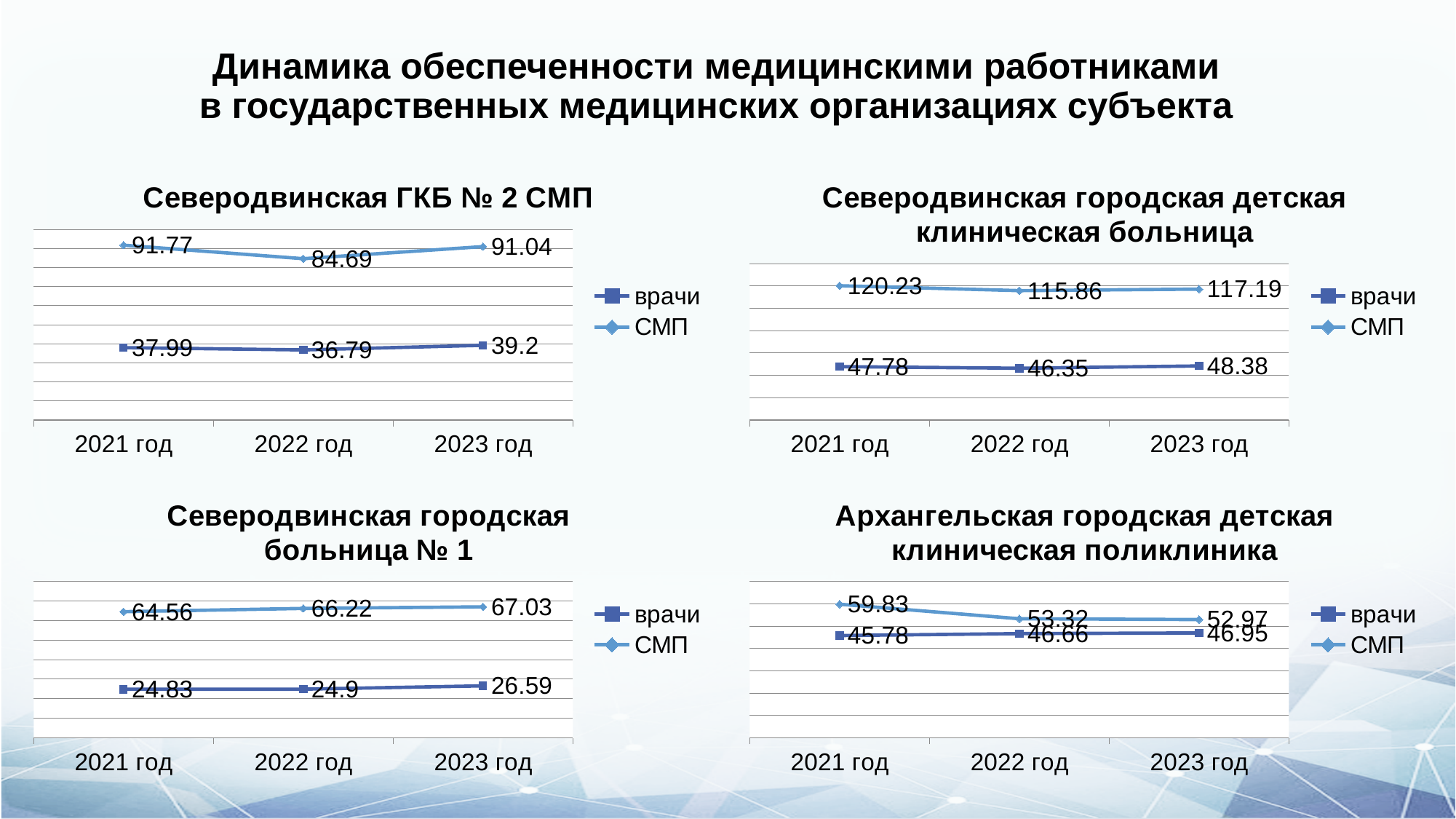
In the chart titled 'Архангельская городская детская клиническая поликлиника', what is the value for СМП in 2023 год? 52.97 In the chart titled 'Северодвинская городская больница № 1', how many series does the legend list? 2 In the chart titled 'Северодвинская ГКБ № 2 СМП', what is the difference between the СМП value in 2021 год and in 2022 год? 7.08 In the chart titled 'Северодвинская городская больница № 1', does the СМП value rise or fall from 2021 год to 2023 год? rise In the chart titled 'Северодвинская ГКБ № 2 СМП', what is the value for врачи in 2023 год? 39.2 In the chart titled 'Северодвинская городская детская клиническая больница', in which year is the врачи value lowest? 2022 год In the chart titled 'Северодвинская городская детская клиническая больница', how many years are shown on the x axis? 3 What kind of chart is the one titled 'Архангельская городская детская клиническая поликлиника'? line chart In the chart titled 'Северодвинская городская детская клиническая больница', what is the value for СМП in 2021 год? 120.23 In the chart titled 'Северодвинская городская больница № 1', what is the value for врачи in 2021 год? 24.83 In the chart titled 'Северодвинская ГКБ № 2 СМП', what is the value for СМП in 2022 год? 84.69 In the chart titled 'Архангельская городская детская клиническая поликлиника', in which year is the СМП value highest? 2021 год